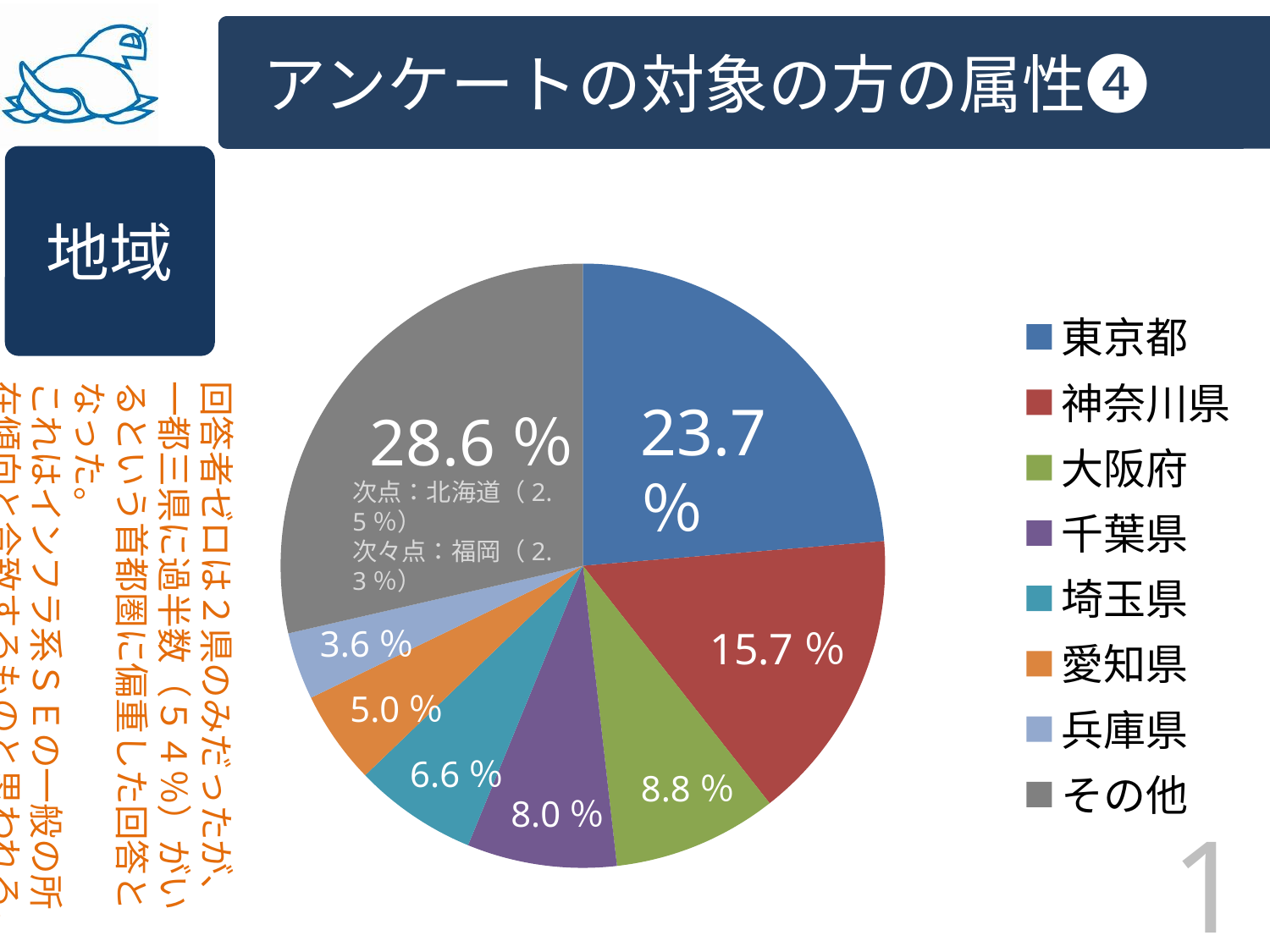
What is the share for 兵庫県 in the pie chart? 3.6 % What is the share for 東京都 in the pie chart? 23.7 % What is the share for 埼玉県 in the pie chart? 6.6 % Which is larger, the slice for 千葉県 or the slice for 愛知県? 千葉県 What is the share for 神奈川県 in the pie chart? 15.7 % How many categories does the legend of the pie chart list? 8 Which category has the smallest slice in the pie chart? 兵庫県 What type of chart is shown on the slide? pie chart Which category has the largest slice in the pie chart? その他 What is the difference in percentage points between 東京都 and 神奈川県? 8.0 What is the share for 大阪府 in the pie chart? 8.8 % What colour is the slice for 東京都 in the pie chart? blue